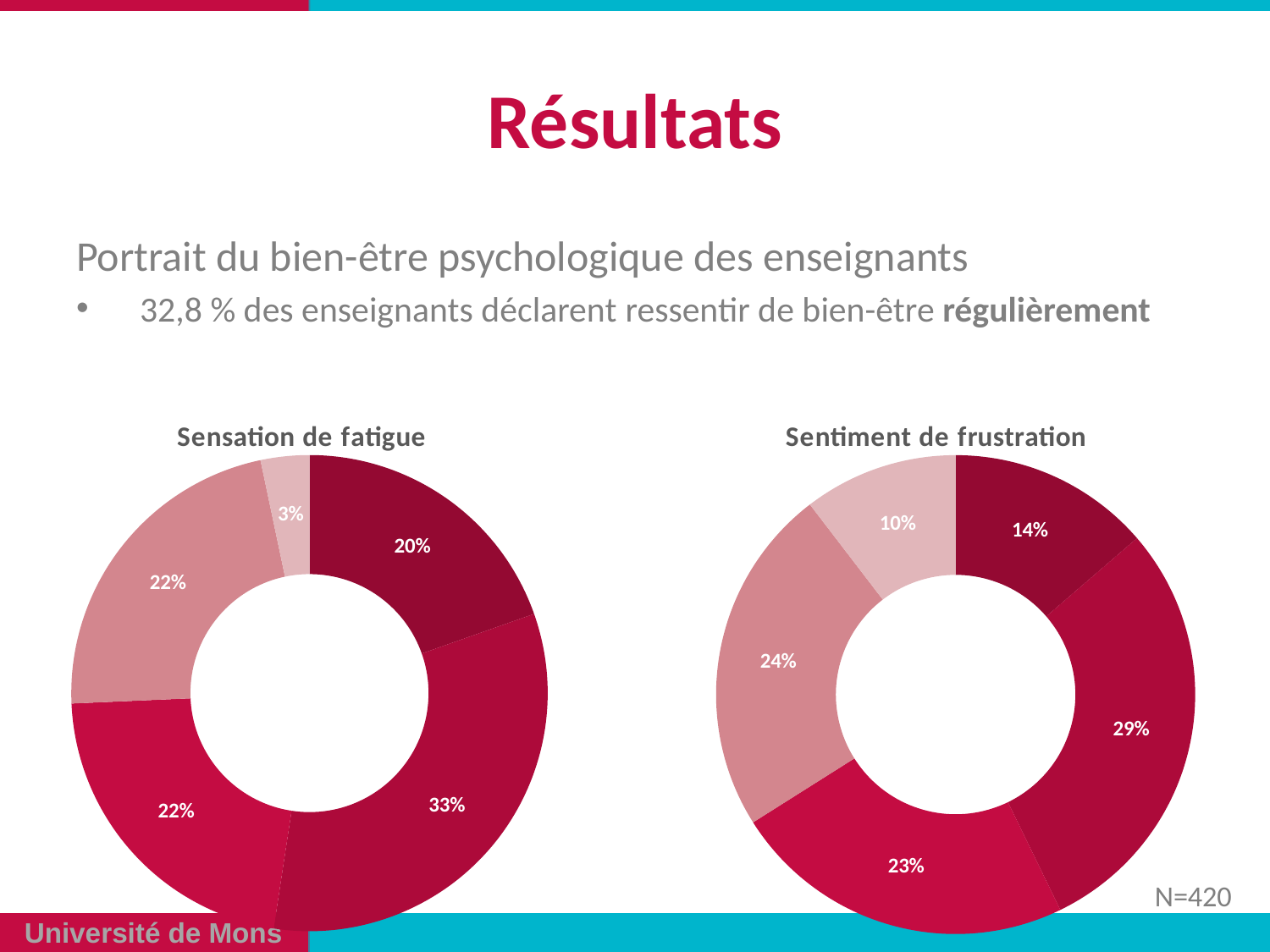
In the "Sentiment de frustration" chart, what is the value of the largest slice? 29% In the "Sensation de fatigue" chart, what is the value of the smallest slice? 3% In the "Sensation de fatigue" chart, what is the value of the largest slice? 33% In the "Sentiment de frustration" chart, what is the difference between the largest slice and the smallest slice? 19 percentage points Which chart has the larger smallest slice, "Sensation de fatigue" or "Sentiment de frustration"? Sentiment de frustration What kind of chart is the "Sensation de fatigue" chart? Doughnut chart In the "Sensation de fatigue" chart, what is the difference between the largest slice and the smallest slice? 30 percentage points In the "Sentiment de frustration" chart, what is the value of the smallest slice? 10% How many slices does the "Sentiment de frustration" chart have? 5 How many slices does the "Sensation de fatigue" chart have? 5 What is the title of the chart on the left of the slide? Sensation de fatigue What sample size (N) is shown on the slide? N=420